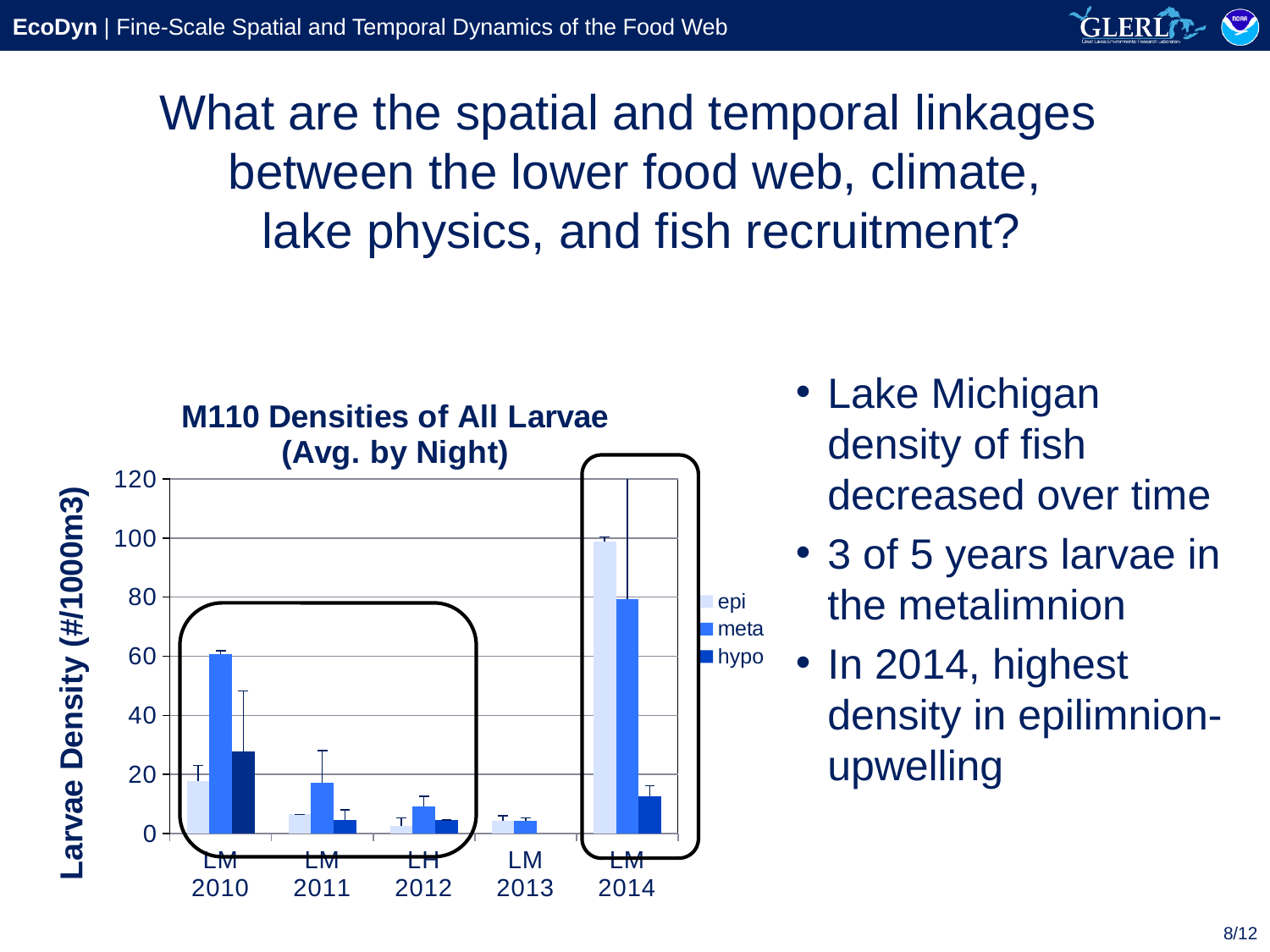
What is the label of the y axis of the chart? Larvae Density (#/1000m3) Which year category has the tallest bar in the chart? LM 2014 Is the meta value for LM 2010 greater or less than 40? greater What kind of chart is shown on the slide? bar chart Is the hypo value for LM 2014 greater or less than 20? less Which is larger, the meta value for LM 2010 or the meta value for LM 2011? LM 2010 What is the title of the chart? M110 Densities of All Larvae (Avg. by Night) Is the epi value for LM 2014 greater or less than 80? greater Which series has the highest value in LM 2010? meta How many year categories are shown along the x axis of the chart? 5 Which series has the highest value in LM 2014? epi How many series does the legend of the chart list? 3